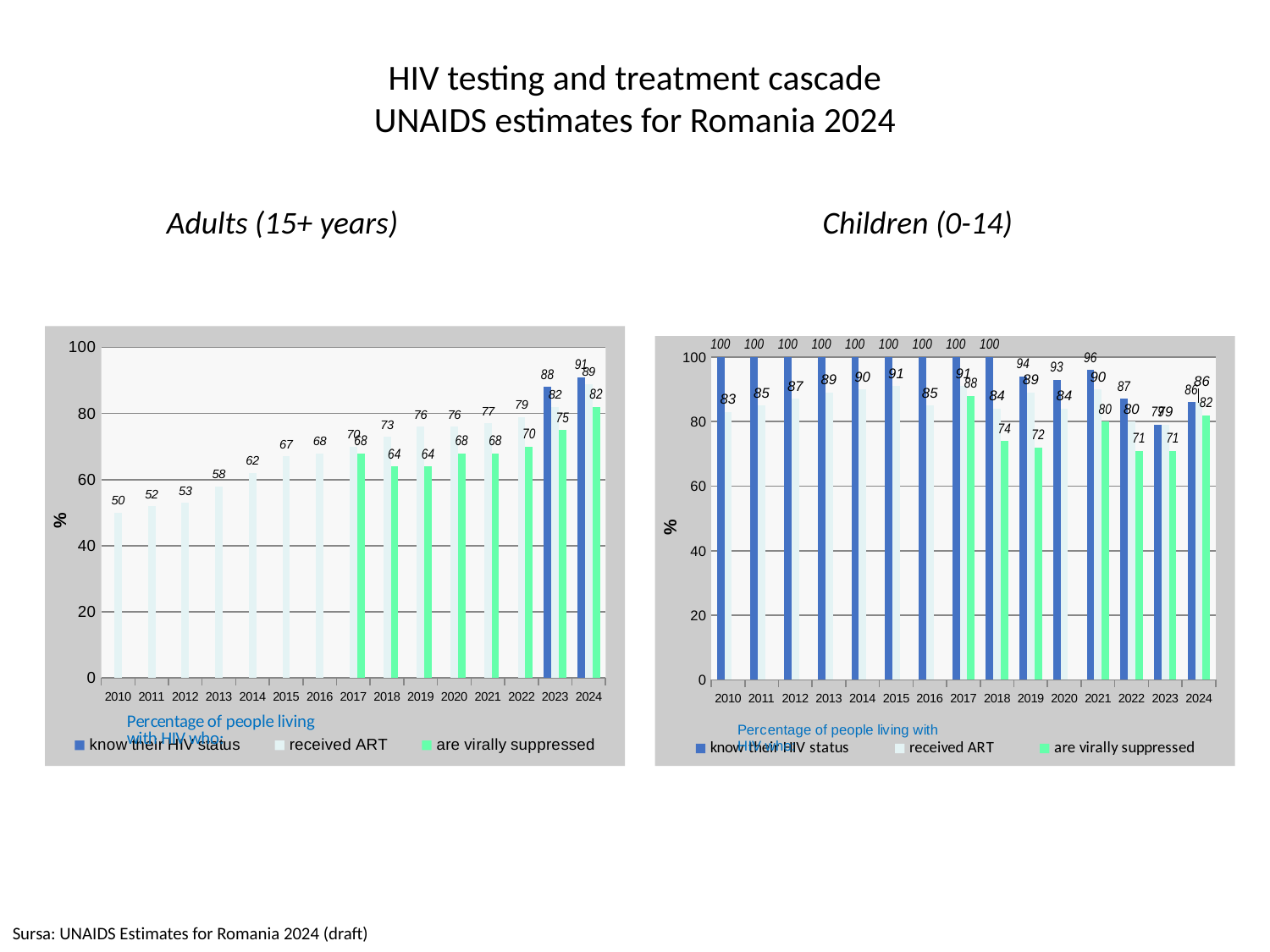
On the Adults (15+ years) chart, what percentage received ART in 2010? 50 What type of chart is the Adults (15+ years) chart? bar chart How many series does the legend of the Adults (15+ years) chart list? 3 On the Adults (15+ years) chart, does the received ART value rise or fall from 2010 to 2024? rise On the Children (0-14) chart, what percentage knew their HIV status in 2023? 79 On the Adults (15+ years) chart, by how many percentage points did the received ART value increase from 2010 to 2024? 39 On the Children (0-14) chart, what is the difference between the know their HIV status value and the are virally suppressed value in 2024? 4 On the Adults (15+ years) chart, what percentage were virally suppressed in 2023? 75 On the Children (0-14) chart, in which year is the know their HIV status value lowest? 2023 On the Children (0-14) chart, what percentage were virally suppressed in 2019? 72 On the Adults (15+ years) chart, what percentage knew their HIV status in 2024? 91 On the Children (0-14) chart, which year has the higher received ART value, 2015 or 2016? 2015